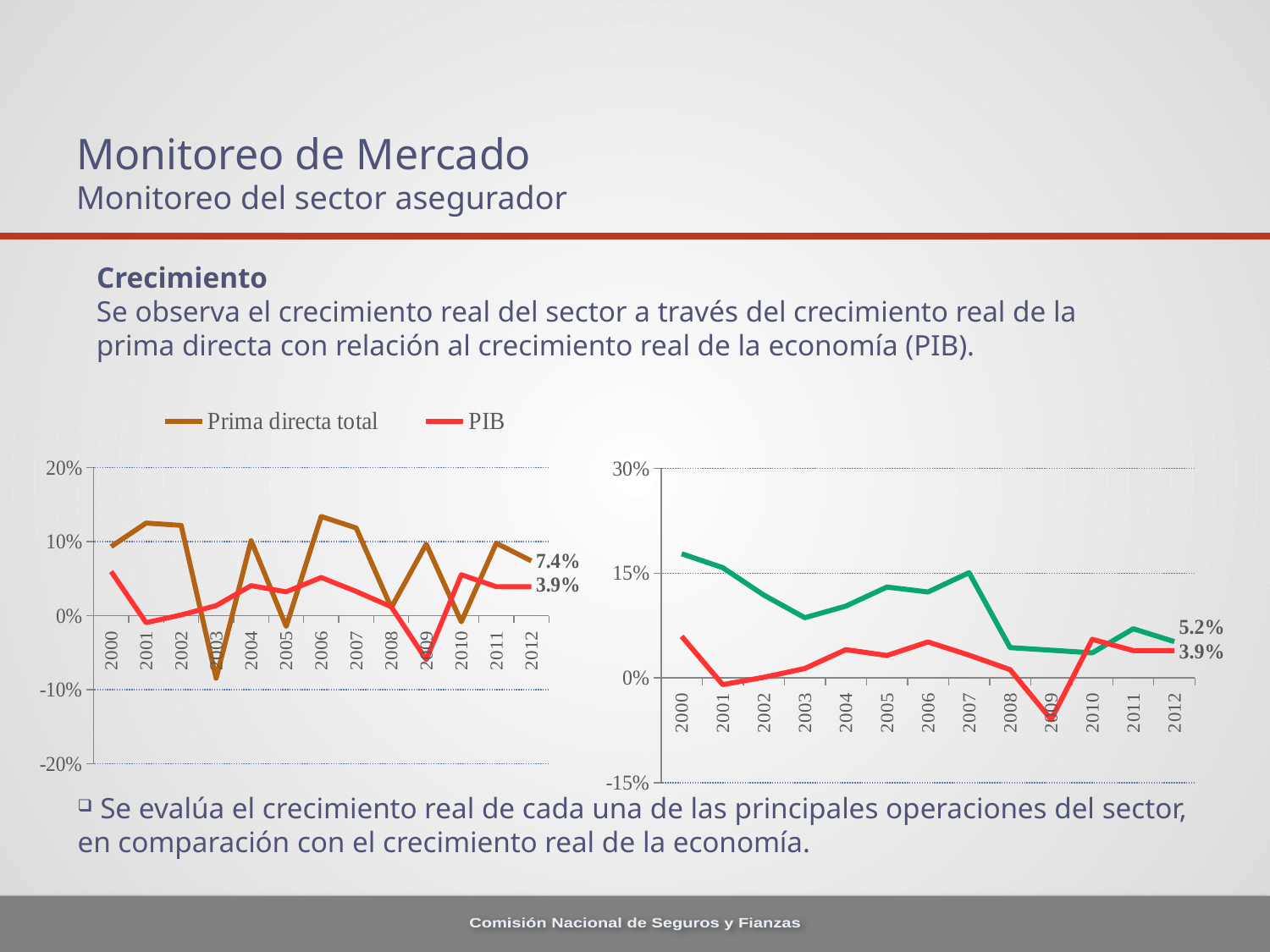
In the right chart, is the value of the red line in 2009 greater or less than 0%? less In the left chart, what is the labelled value of Prima directa total in 2012? 7.4% In the left chart, is the value of Prima directa total in 2006 greater or less than 10%? greater In the left chart, in which year does Prima directa total reach its lowest value? 2003 In the left chart, which series has the larger value in 2012, Prima directa total or PIB? Prima directa total How many series does the legend above the left chart list? 2 In the right chart, what is the labelled value of the red line in 2012? 3.9% In the left chart, what is the difference between the 2012 values of Prima directa total and PIB? 3.5 percentage points In the left chart, what is the labelled value of PIB in 2012? 3.9% In the right chart, what is the difference between the 2012 values of the green line and the red line? 1.3 percentage points In the right chart, what is the labelled value of the green line in 2012? 5.2% In the left chart, is the value of Prima directa total in 2003 greater or less than 0%? less